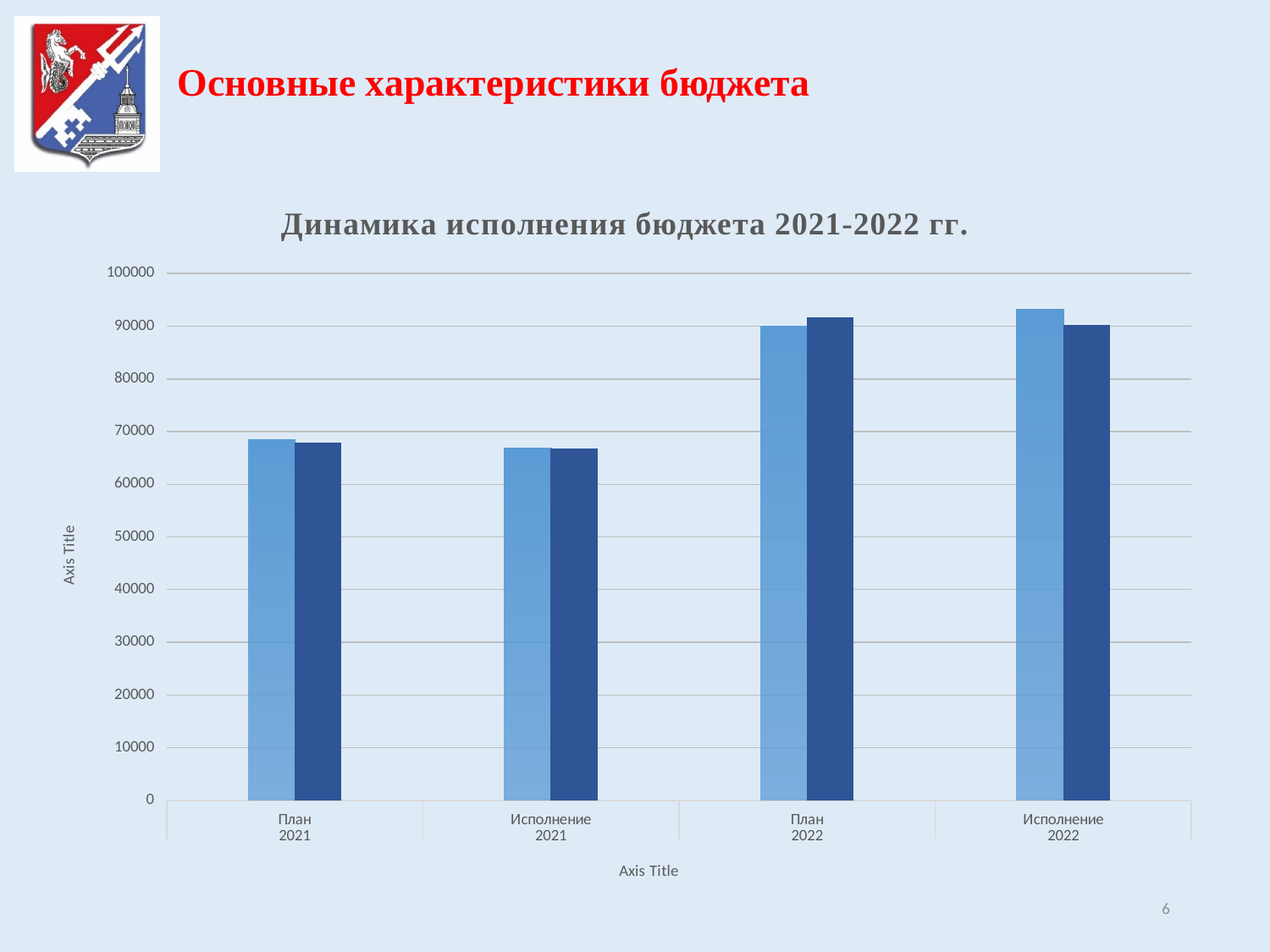
Which category has the tallest bar in the chart? Исполнение 2022 Is the light blue bar for План 2021 greater or less than 60000? greater Is the light blue bar for План 2022 greater or less than 80000? greater Which is larger, the light blue bar for План 2022 or the light blue bar for План 2021? План 2022 Is the dark blue bar for Исполнение 2022 greater or less than 100000? less How many categories are shown on the x axis of the chart? 4 What is the title of the chart? Динамика исполнения бюджета 2021-2022 гг. Which is larger, the dark blue bar for Исполнение 2021 or the dark blue bar for Исполнение 2022? Исполнение 2022 What is the label shown on the vertical axis of the chart? Axis Title What type of chart is shown on the slide? Bar chart